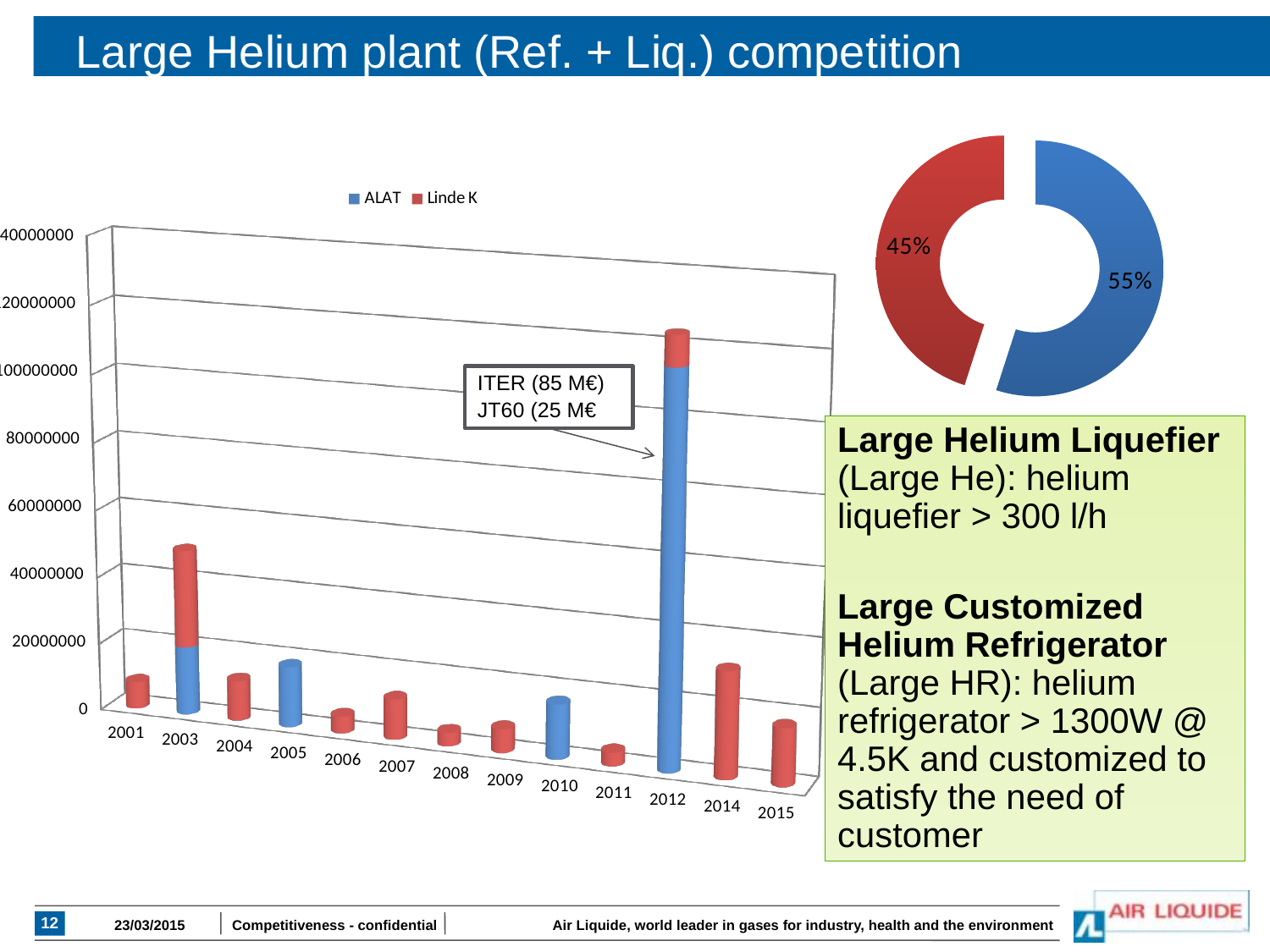
In the bar chart, which year has the tallest ALAT (blue) bar? 2012 In the doughnut chart at the top right, which slice is larger, the blue one or the red one? blue How many series does the legend of the bar chart list? 2 In the bar chart, which year has the tallest bar? 2012 How many years are shown on the x axis of the bar chart? 13 In the bar chart, which series is shown in blue according to the legend? ALAT In the bar chart, which year has a larger total bar, 2003 or 2005? 2003 In the doughnut chart at the top right, what percentage is shown on the red slice? 45% In the doughnut chart at the top right, what percentage is shown on the blue slice? 55% What kind of chart is the large chart on the left of the slide? bar chart In the bar chart, is the total value for 2003 greater or less than 60000000? less In the bar chart, is the total value for 2012 greater or less than 80000000? greater